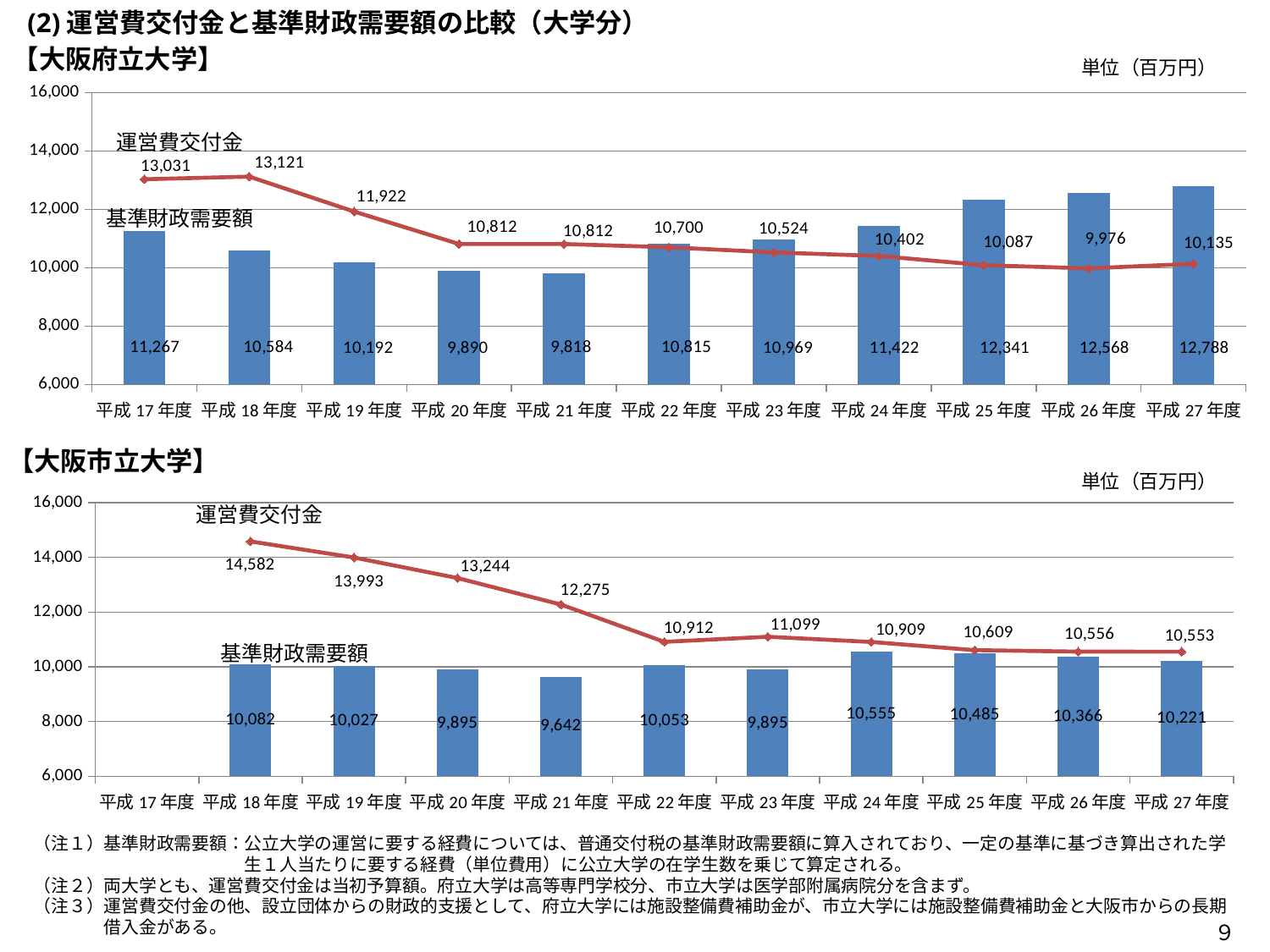
In the 大阪市立大学 chart, which year has the highest 基準財政需要額? 平成 24 年度 In the 大阪府立大学 chart, does the 運営費交付金 line generally rise or fall from 平成 18 年度 to 平成 26 年度? fall What unit is stated for the values in both charts? 百万円 In the 大阪市立大学 chart, what is the 基準財政需要額 value for 平成 21 年度? 9,642 In the 大阪府立大学 chart, what is the 基準財政需要額 value for 平成 27 年度? 12,788 In the 大阪府立大学 chart, what is the difference between 基準財政需要額 and 運営費交付金 in 平成 27 年度? 2,653 In the 大阪府立大学 chart, which year has the lowest 基準財政需要額? 平成 21 年度 In the 大阪市立大学 chart, what is the 運営費交付金 value for 平成 18 年度? 14,582 In the 大阪府立大学 chart, what is the 運営費交付金 value for 平成 19 年度? 11,922 In the 大阪市立大学 chart, what is the difference between 運営費交付金 and 基準財政需要額 in 平成 18 年度? 4,500 In the 大阪府立大学 chart, which is larger in 平成 18 年度: 運営費交付金 or 基準財政需要額? 運営費交付金 In the 大阪市立大学 chart, how many bars (years with 基準財政需要額 data) are plotted? 10